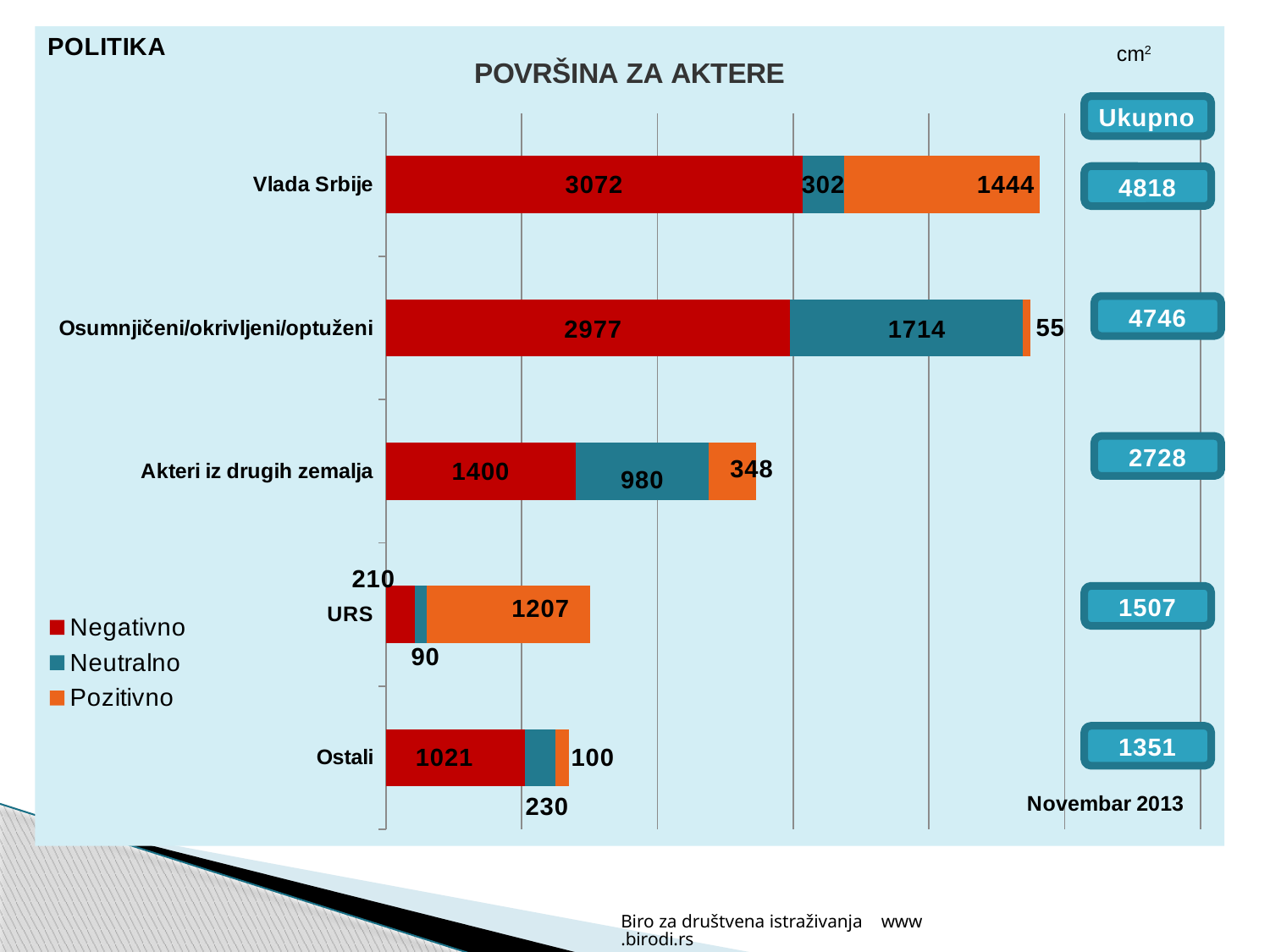
What kind of chart is shown on the slide? Stacked bar chart What is the Pozitivno value for URS? 1207 What is the Neutralno value for Osumnjičeni/okrivljeni/optuženi? 1714 Which is larger: the Neutralno value for Akteri iz drugih zemalja or the Neutralno value for Ostali? Akteri iz drugih zemalja Which category has the lowest Ukupno (total) value? Ostali How many categories are shown on the chart? 5 What is the difference between the Pozitivno values for Vlada Srbije and Osumnjičeni/okrivljeni/optuženi? 1389 What is the Pozitivno value for Akteri iz drugih zemalja? 348 How many series does the legend list? 3 What is the total (Ukupno) for Akteri iz drugih zemalja? 2728 What is the Negativno value for Vlada Srbije? 3072 Which category has the highest Ukupno (total) value? Vlada Srbije